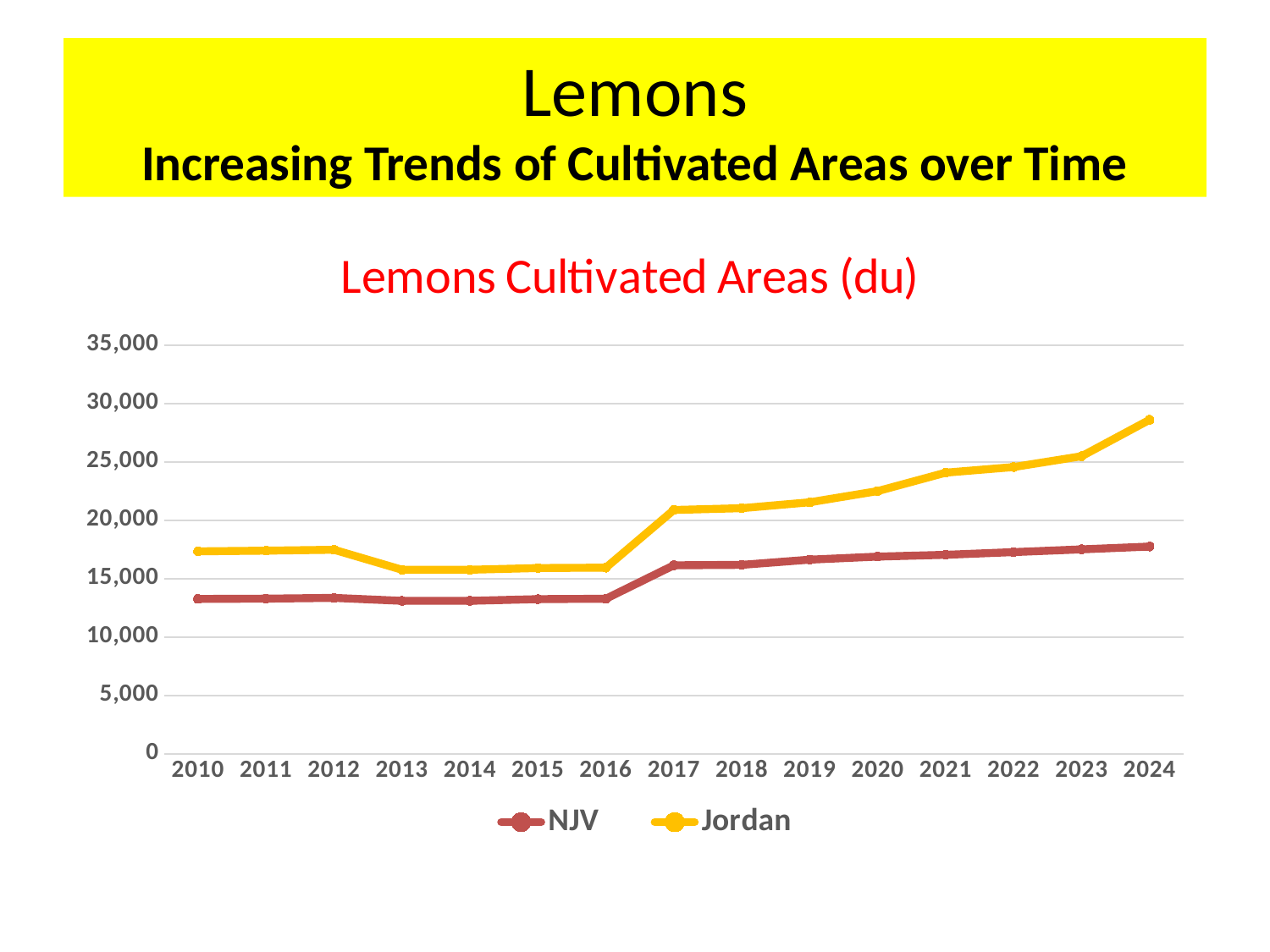
Is the value for NJV in 2010 greater or less than 15,000? less Is the value for NJV in 2024 greater or less than 15,000? greater Does the Jordan series generally rise or fall from 2016 to 2024? rise Is the value for Jordan in 2013 greater or less than 20,000? less What is the title of the chart? Lemons Cultivated Areas (du) What type of chart is shown on the slide? line chart Which series is drawn in yellow? Jordan How many years are shown on the x axis? 15 How many series does the legend list? 2 In which year does the Jordan series reach its highest value? 2024 Which series has the higher value in 2024, NJV or Jordan? Jordan